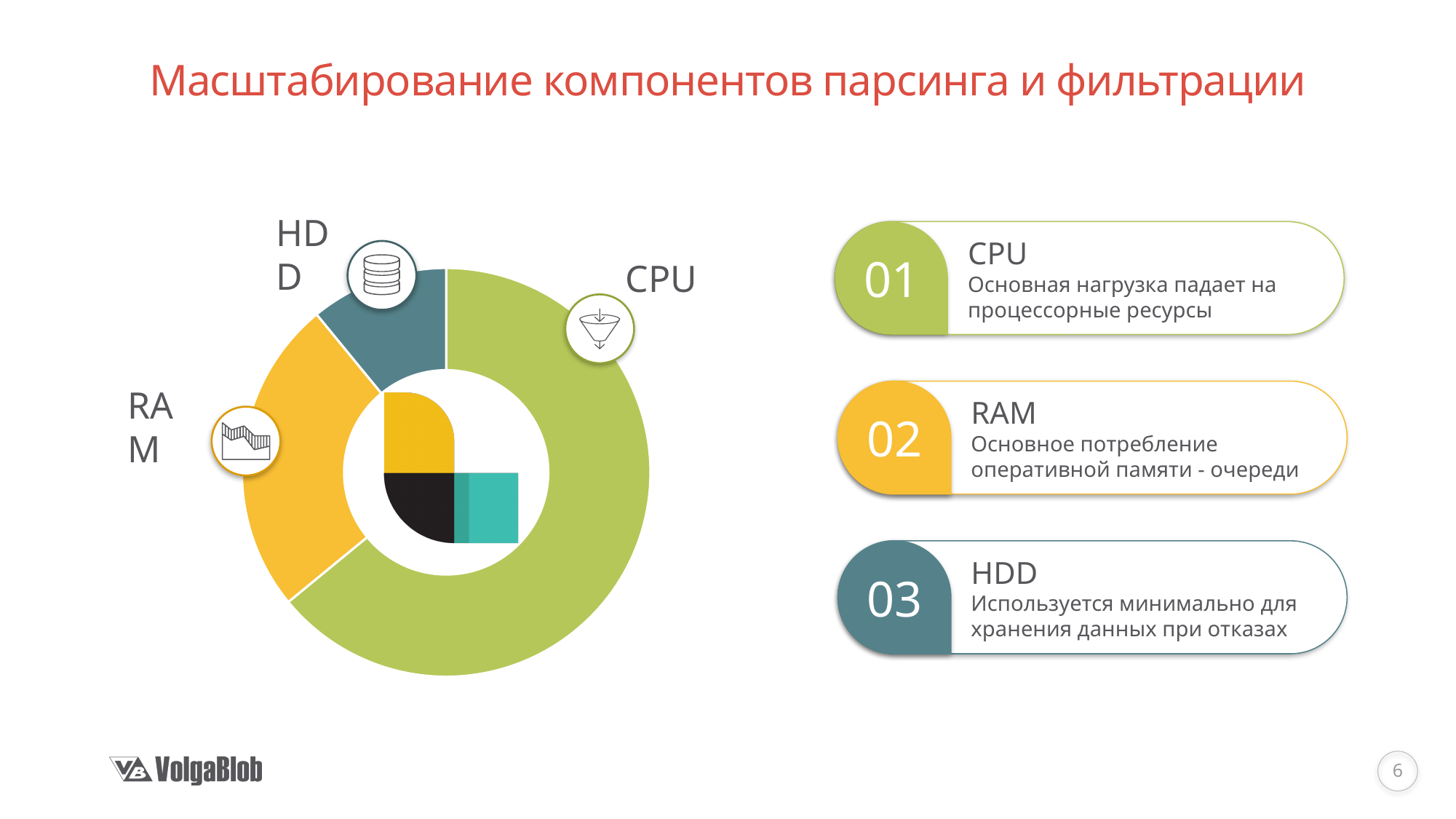
What colour is the HDD segment of the donut chart? Teal What colour is the CPU segment of the donut chart? Green Which segment is larger in the donut chart, CPU or RAM? CPU Which segment is larger in the donut chart, RAM or HDD? RAM Does the CPU segment take up more or less than half of the donut chart? more Which segment of the donut chart is the smallest? HDD Which segment of the donut chart is the largest? CPU What kind of chart is shown on the slide? Donut chart How many segments does the donut chart have? 3